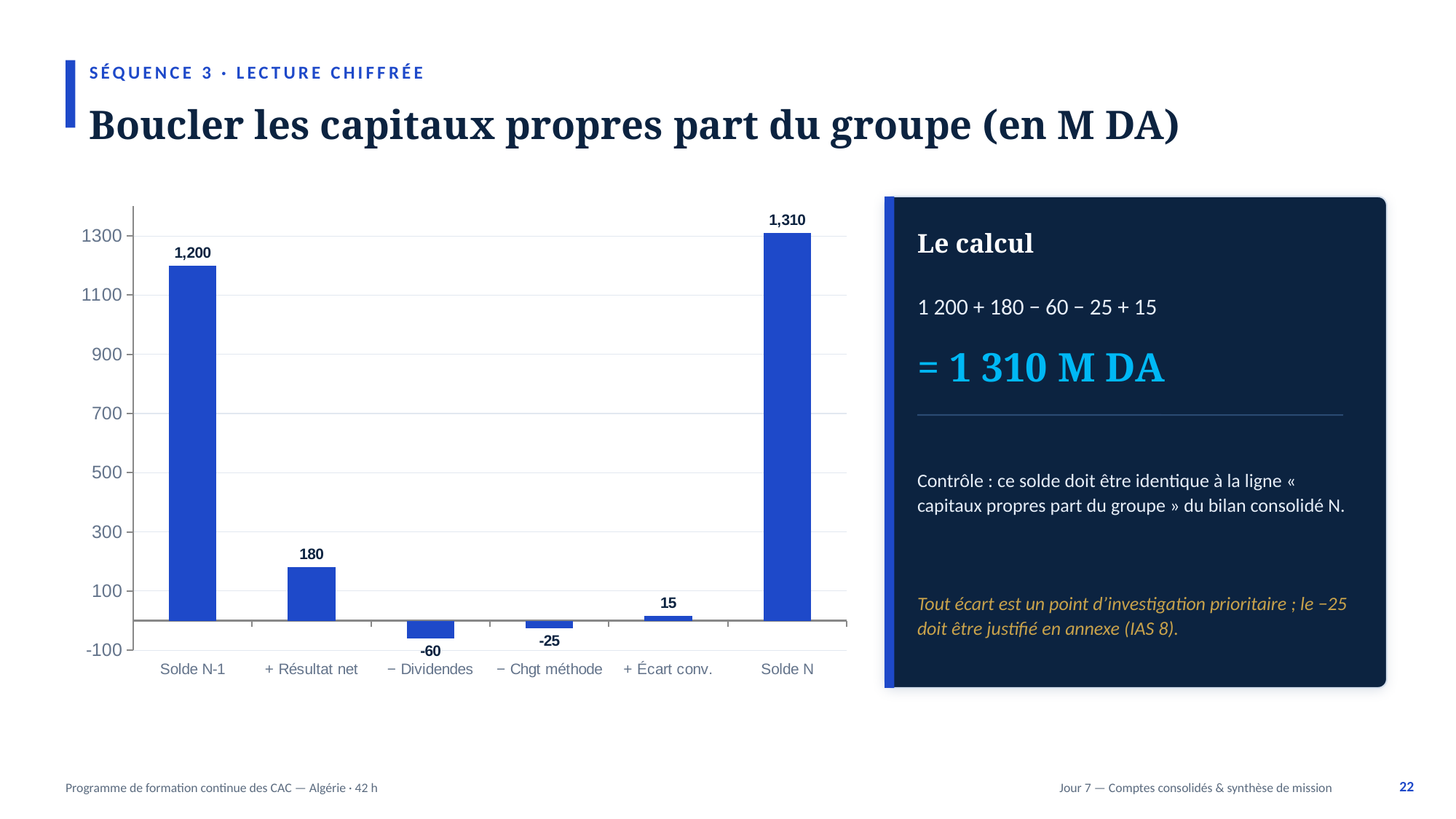
Which is larger, the value for + Résultat net or the value for + Écart conv.? + Résultat net What is the difference between Solde N and Solde N-1? 110 Which category has the lowest value? − Dividendes Is the value for + Résultat net greater or less than 300? less How many categories are shown on the x axis? 6 What is the value for Solde N-1? 1,200 What is the value for − Dividendes? -60 What is the value for + Résultat net? 180 What is the value for − Chgt méthode? -25 What is the value for Solde N? 1,310 Which category has the highest value? Solde N What kind of chart is this? bar chart